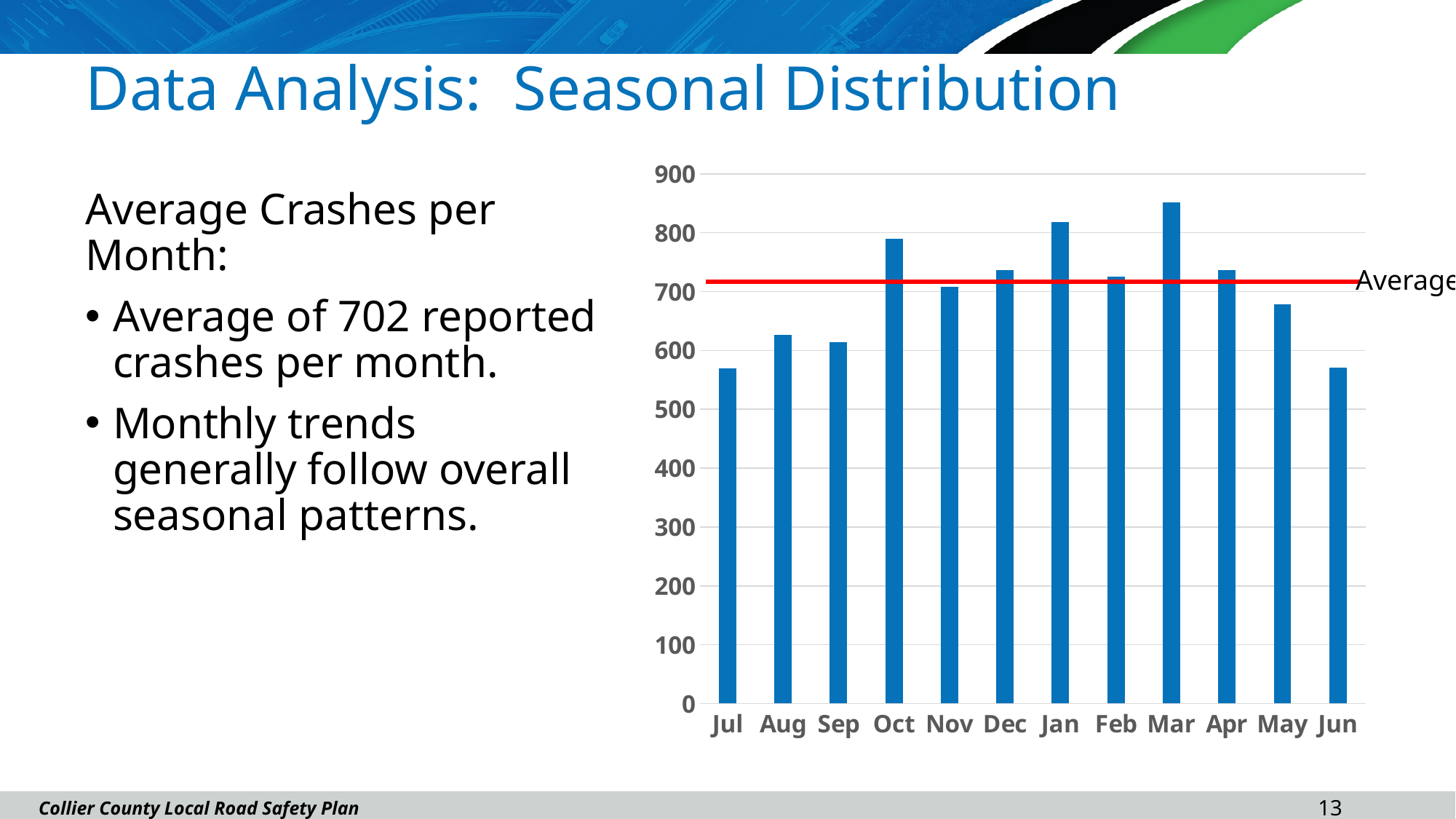
Which month has the larger value, Jan or Feb? Jan Which month has the highest bar in the chart? Mar Is the value for May greater or less than 700? less What does the red horizontal line on the chart represent? Average Do the bar values rise or fall from Jul to Oct? rise Is the value for Oct greater or less than 700? greater How many months are shown on the x axis of the chart? 12 Is the value for Mar greater or less than 800? greater Which month has the larger value, Oct or Nov? Oct What kind of chart is shown on the slide? bar chart